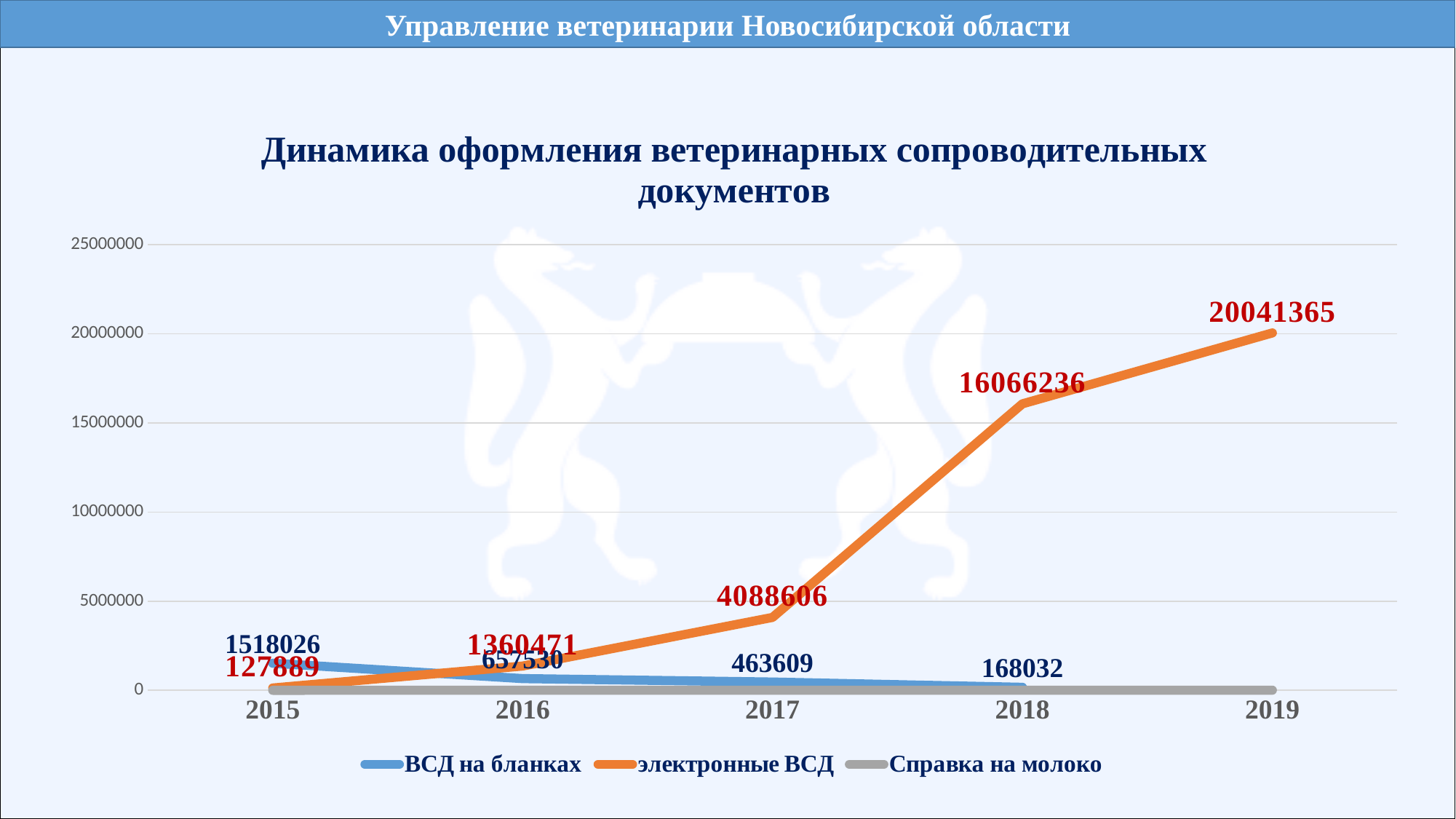
How many series does the legend list? 3 Does the value for электронные ВСД rise or fall from 2015 to 2019? rise What is the value for ВСД на бланках in 2015? 1518026 In which year is the value for электронные ВСД highest? 2019 In which year is the value for ВСД на бланках lowest? 2018 What is the value for ВСД на бланках in 2018? 168032 What type of chart is shown on the slide? line chart What is the value for электронные ВСД in 2019? 20041365 Which is larger in 2016: ВСД на бланках or электронные ВСД? электронные ВСД What is the value for электронные ВСД in 2017? 4088606 How many years are shown on the x axis? 5 What is the difference between the электронные ВСД values for 2019 and 2018? 3975129